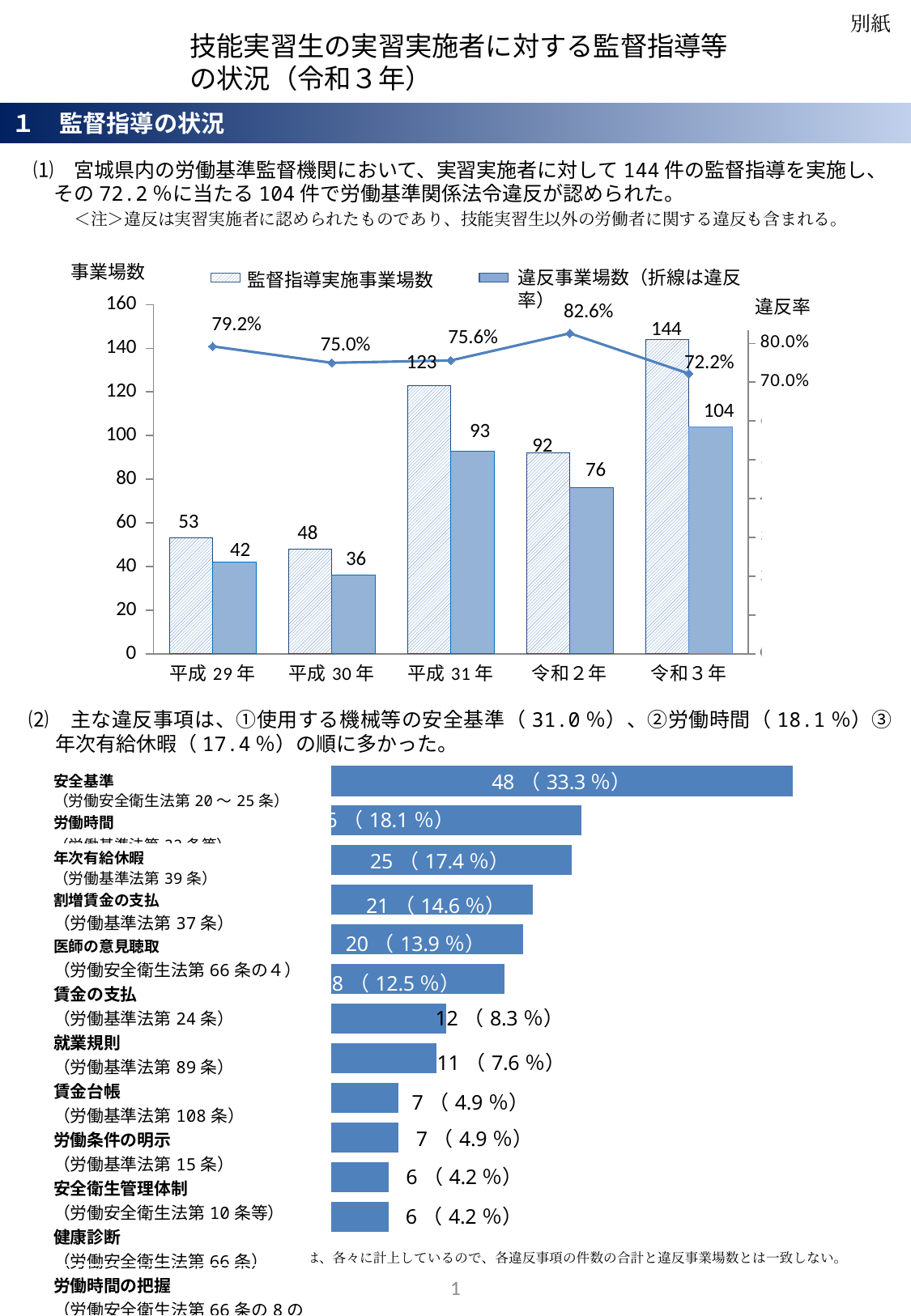
In the top chart, how many years are shown on the x axis? 5 In the top chart, what is the 違反率 for 令和2年? 82.6% In the top chart, what is the difference between the 監督指導実施事業場数 and the 違反事業場数 for 令和3年? 40 In the top chart, which year has the lowest 違反事業場数? 平成30年 In the top chart, which year has the lowest 違反率? 令和3年 What kind of chart is the bottom chart showing violation items? Bar chart In the top chart, which year has the highest 監督指導実施事業場数? 令和3年 In the top chart, what is the 違反事業場数 for 平成31年? 93 In the bottom chart, what is the value shown on the longest bar (安全基準)? 48 (33.3%) In the top chart, which is larger: the 違反事業場数 for 平成31年 or for 令和2年? 平成31年 In the top chart, what is the number of 監督指導実施事業場数 for 令和3年? 144 In the top chart, how many series does the legend list? 2